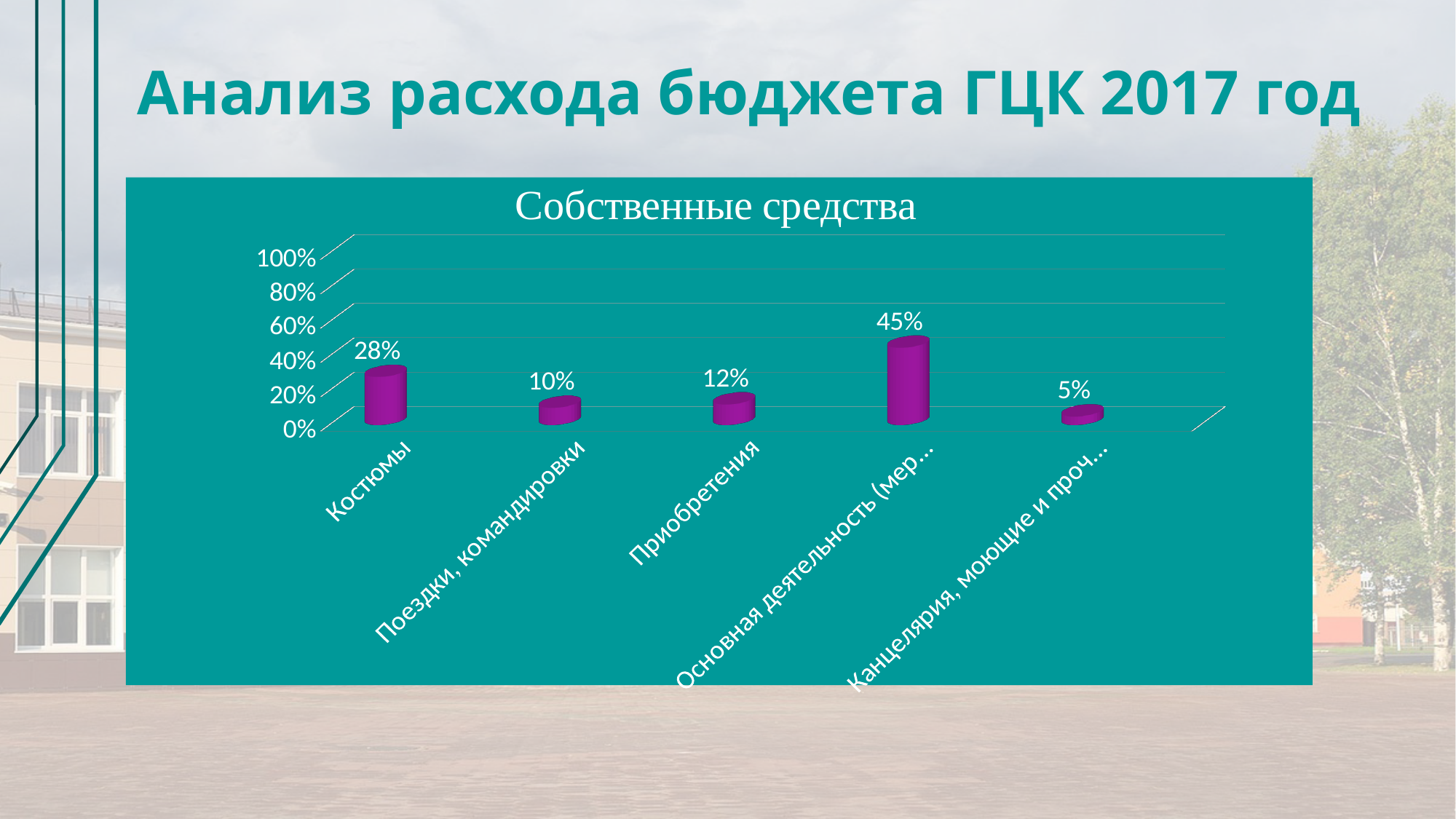
What is the title of the chart? Собственные средства What is the value for the category labelled Основная деятельность? 45% Which is larger, the value for Приобретения or the value for Поездки, командировки? Приобретения What is the difference between the values for Основная деятельность and Костюмы? 17% Which category has the highest value? Основная деятельность How many categories are shown on the chart? 5 What is the value for Костюмы? 28% What is the value for Поездки, командировки? 10% Which category has the lowest value? Канцелярия, моющие и проч. What kind of chart is shown on the slide? bar chart What is the value for Приобретения? 12% Is the value for Костюмы greater or less than 20%? greater